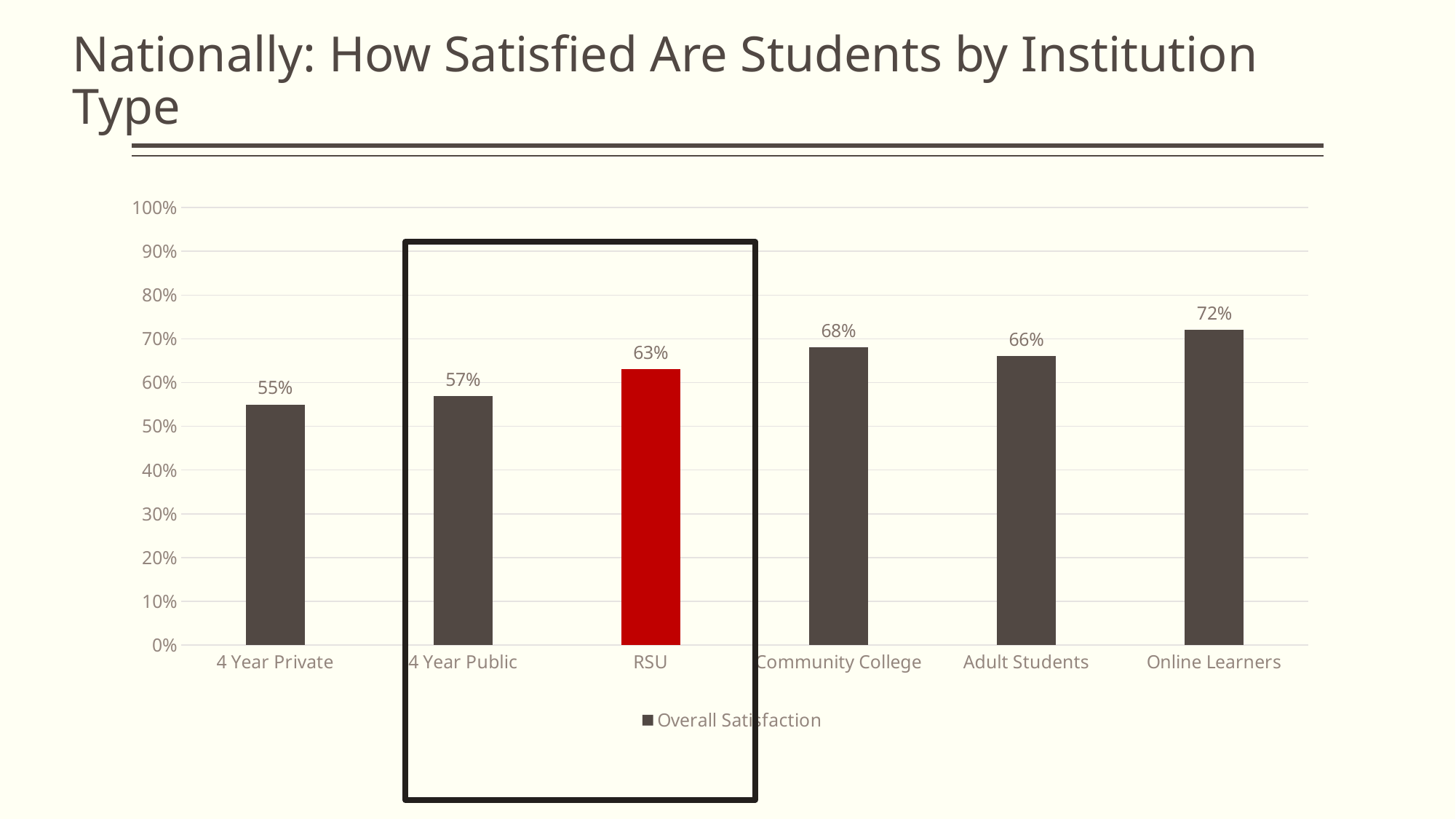
Which institution type has the highest overall satisfaction? Online Learners What kind of chart is shown on the slide? Bar chart What is the difference between the overall satisfaction for Online Learners and 4 Year Public? 15% How many series does the legend list? 1 Which has a higher overall satisfaction, Community College or Adult Students? Community College What is the difference between the overall satisfaction for RSU and 4 Year Public? 6% Is the value for Adult Students greater or less than 60%? greater How many institution types are shown on the x axis? 6 What is the overall satisfaction value for RSU? 63% Which institution type has the lowest overall satisfaction? 4 Year Private What is the overall satisfaction value for Community College? 68% What is the overall satisfaction value for 4 Year Private? 55%